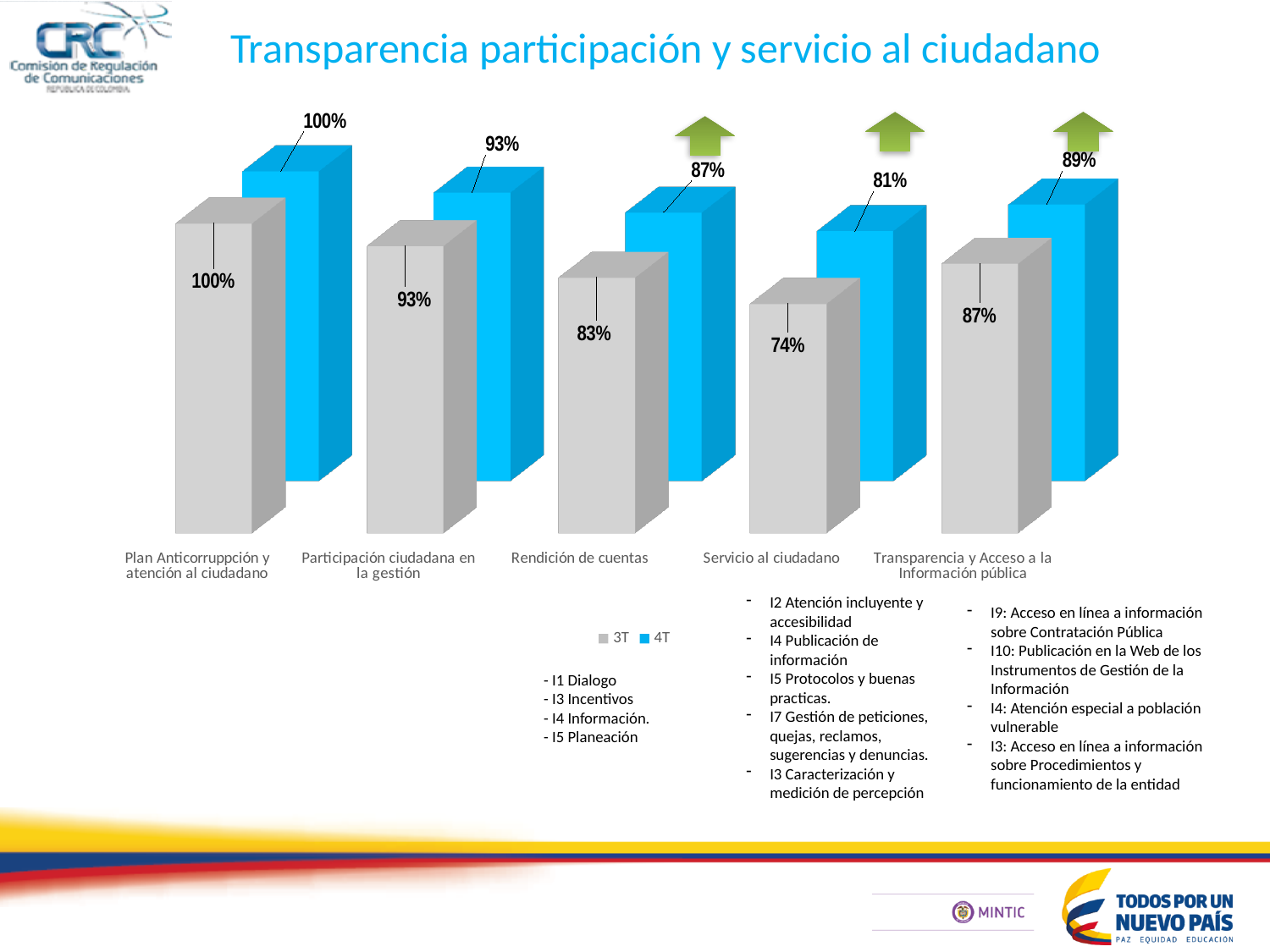
What is the 4T value for Transparencia y Acceso a la Información pública? 89% Which category has the highest 4T value? Plan Anticorruppción y atención al ciudadano Which category has the lowest 3T value? Servicio al ciudadano What is the 4T value for Rendición de cuentas? 87% What is the 3T value for Servicio al ciudadano? 74% How many categories are shown on the chart? 5 Which is larger, the 3T value for Transparencia y Acceso a la Información pública or the 3T value for Rendición de cuentas? Transparencia y Acceso a la Información pública What is the difference between the 4T and 3T values for Rendición de cuentas? 4% What kind of chart is shown on the slide? Bar chart What is the 3T value for Participación ciudadana en la gestión? 93% How many series does the legend list? 2 What is the difference between the 4T and 3T values for Servicio al ciudadano? 7%